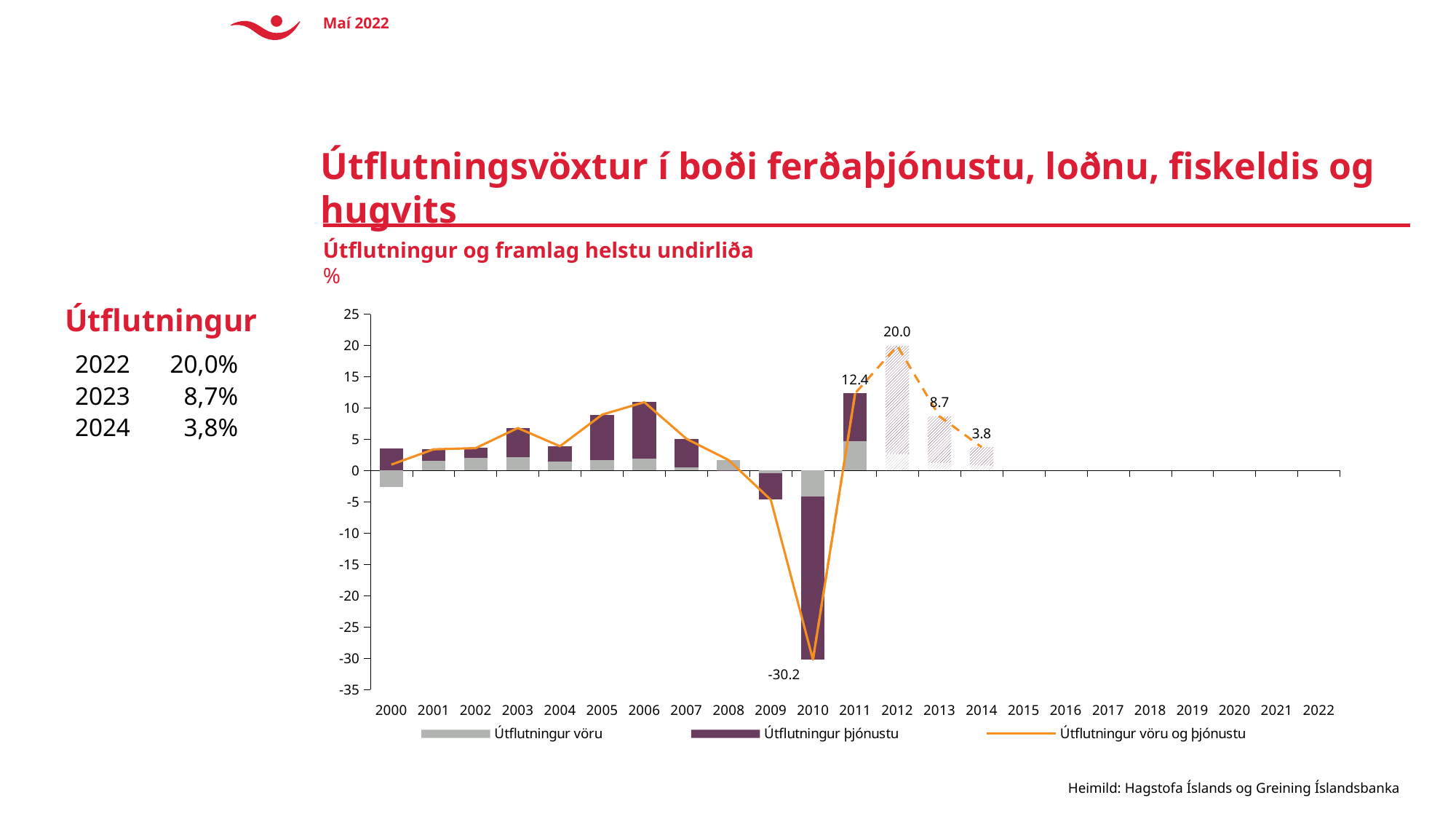
What kind of chart is shown on the slide? bar chart with a line What value is labelled on the chart at the 2010 tick on the x axis? -30.2 What value is labelled on the chart at the 2014 tick on the x axis? 3.8 At which x-axis tick does the chart show its highest labelled value? 2012 What is the difference between the labelled values at the 2012 and 2013 ticks? 11.3 Do the labelled values fall or rise from the 2012 tick to the 2014 tick? fall How many series does the chart legend list? 3 What value is labelled on the chart at the 2011 tick on the x axis? 12.4 Which legend entry is represented by the orange line? Útflutningur vöru og þjónustu Is the value of the Útflutningur vöru og þjónustu line at the 2009 tick greater or less than 0? less What value is labelled on the chart at the 2012 tick on the x axis? 20.0 At which x-axis tick does the chart show its lowest labelled value? 2010